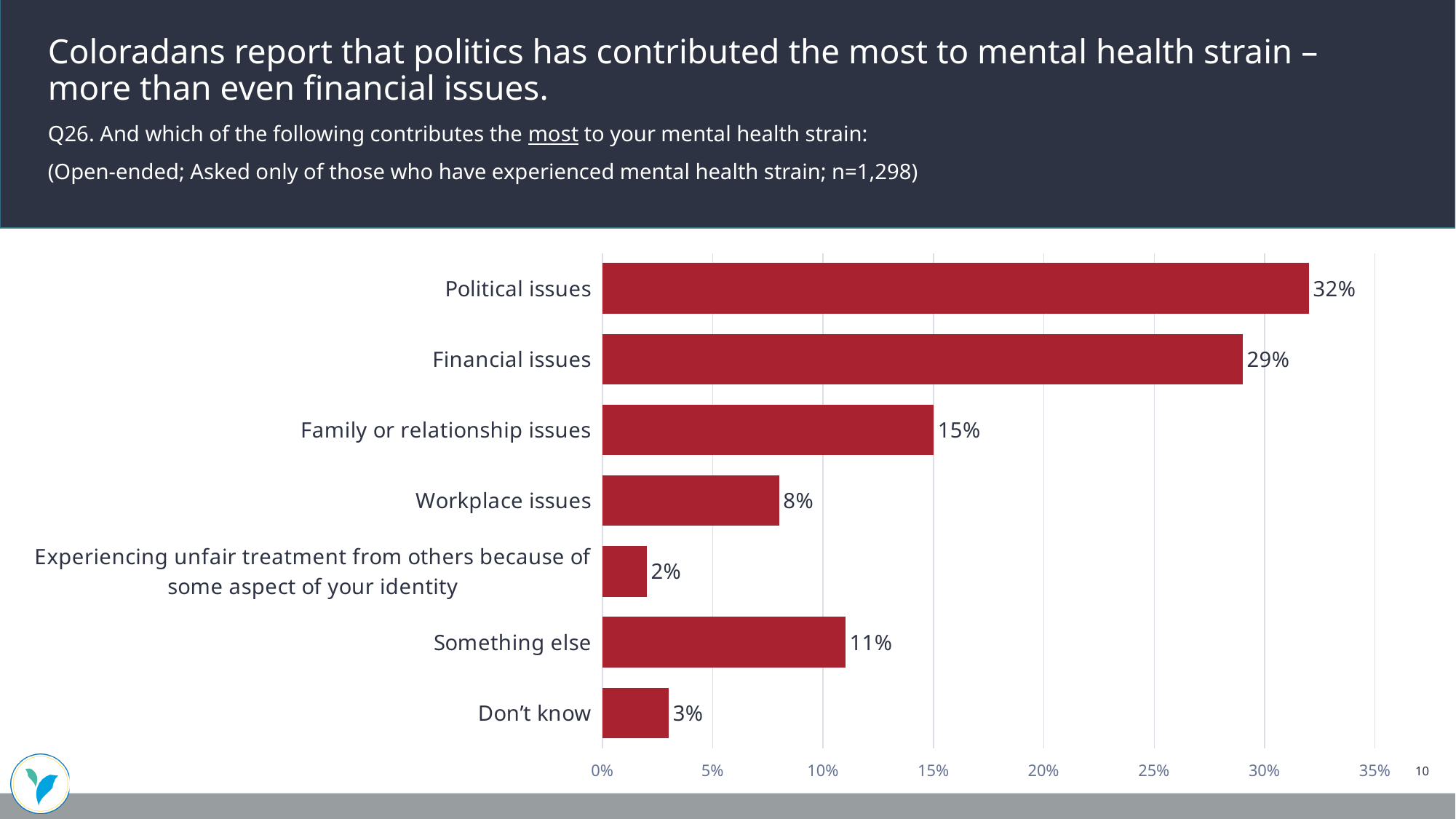
Which category has the highest value in the chart? Political issues Which is larger, the value for Something else or the value for Workplace issues? Something else What kind of chart is shown on the slide? Bar chart What is the highest value labelled on the x axis of the chart? 35% What percentage of respondents said political issues contribute the most to their mental health strain? 32% What is the difference between the values for Political issues and Financial issues? 3 percentage points Which category has the lowest value in the chart? Experiencing unfair treatment from others because of some aspect of your identity What is the value shown for Family or relationship issues? 15% How many categories are shown in the chart? 7 What is the value shown for Financial issues? 29% What percentage is shown for Workplace issues? 8% What is the value shown for Don't know? 3%